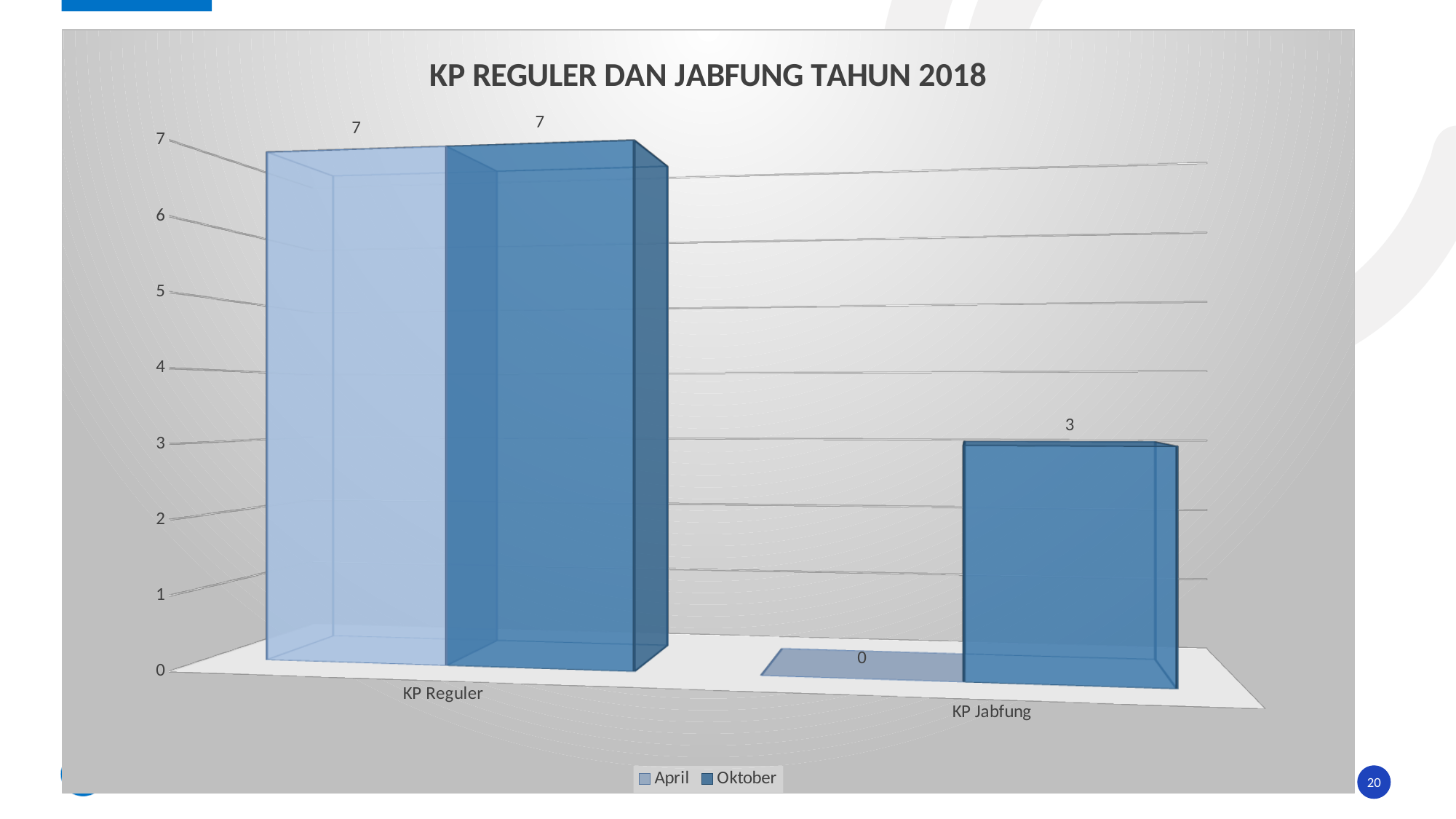
What kind of chart is shown on the slide? Bar chart How many series does the legend list? 2 What is the value for Oktober in the KP Reguler category? 7 Which is larger: the Oktober value for KP Jabfung or the April value for KP Jabfung? Oktober Which category has the lowest value for April? KP Jabfung What is the value for April in the KP Jabfung category? 0 What is the difference between the Oktober values for KP Reguler and KP Jabfung? 4 What is the value for Oktober in the KP Jabfung category? 3 What is the title of the chart? KP REGULER DAN JABFUNG TAHUN 2018 What is the value for April in the KP Reguler category? 7 Which category has the highest value for Oktober? KP Reguler How many categories are shown on the x axis? 2